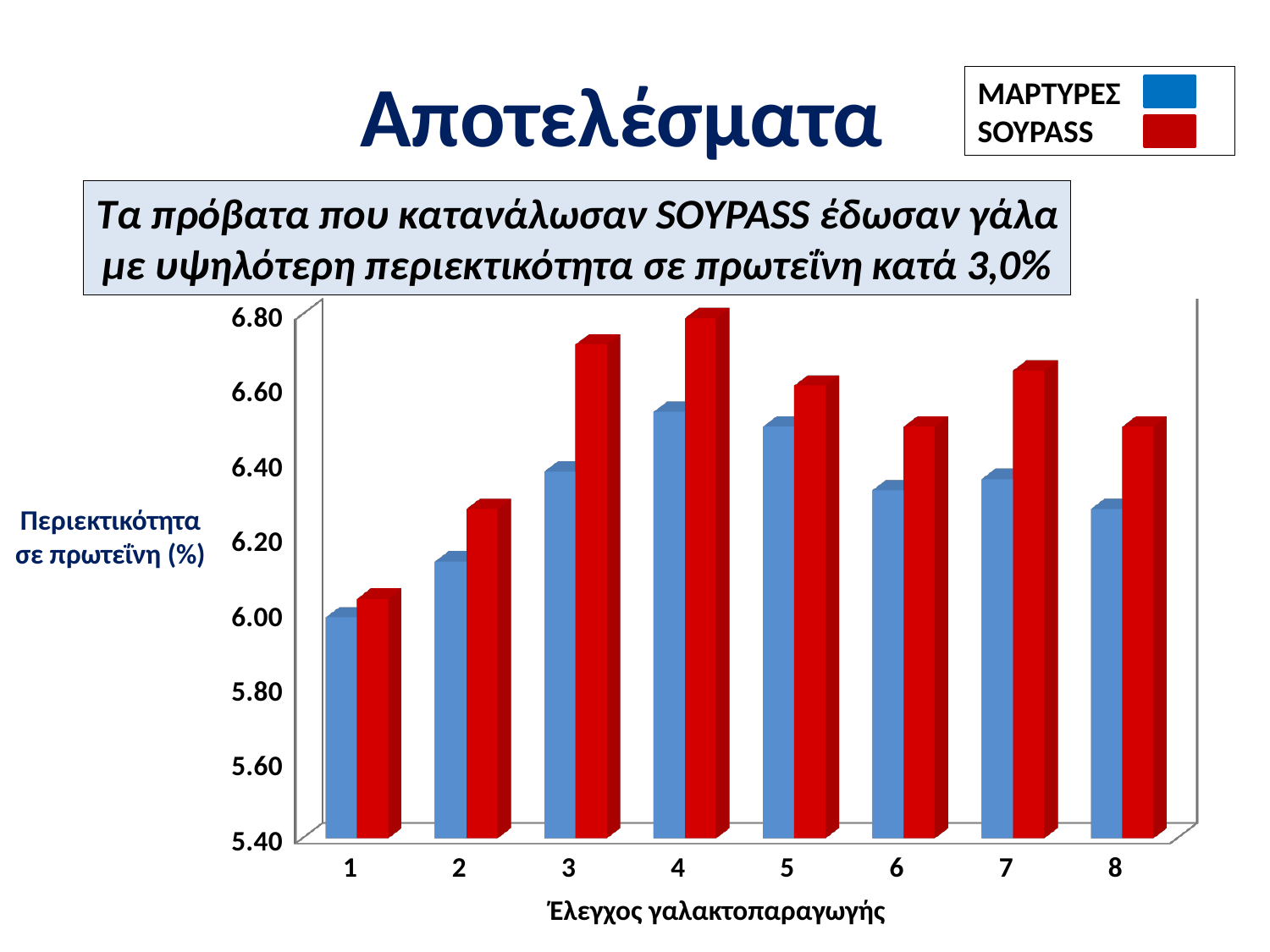
Which colour represents the SOYPASS series in the legend? red Is the ΜΑΡΤΥΡΕΣ value at check 2 greater or less than 6.40? less How many milk-production checks (categories) are shown on the x axis? 8 Is the SOYPASS value at check 3 greater or less than 6.60? greater At which milk-production check is the SOYPASS value lowest? 1 Is the SOYPASS value at check 1 greater or less than 6.20? less How many series does the legend list? 2 What kind of chart is shown on the slide? bar chart At check 3, which series has the larger value, ΜΑΡΤΥΡΕΣ or SOYPASS? SOYPASS At which milk-production check is the ΜΑΡΤΥΡΕΣ value lowest? 1 At which milk-production check is the SOYPASS value highest? 4